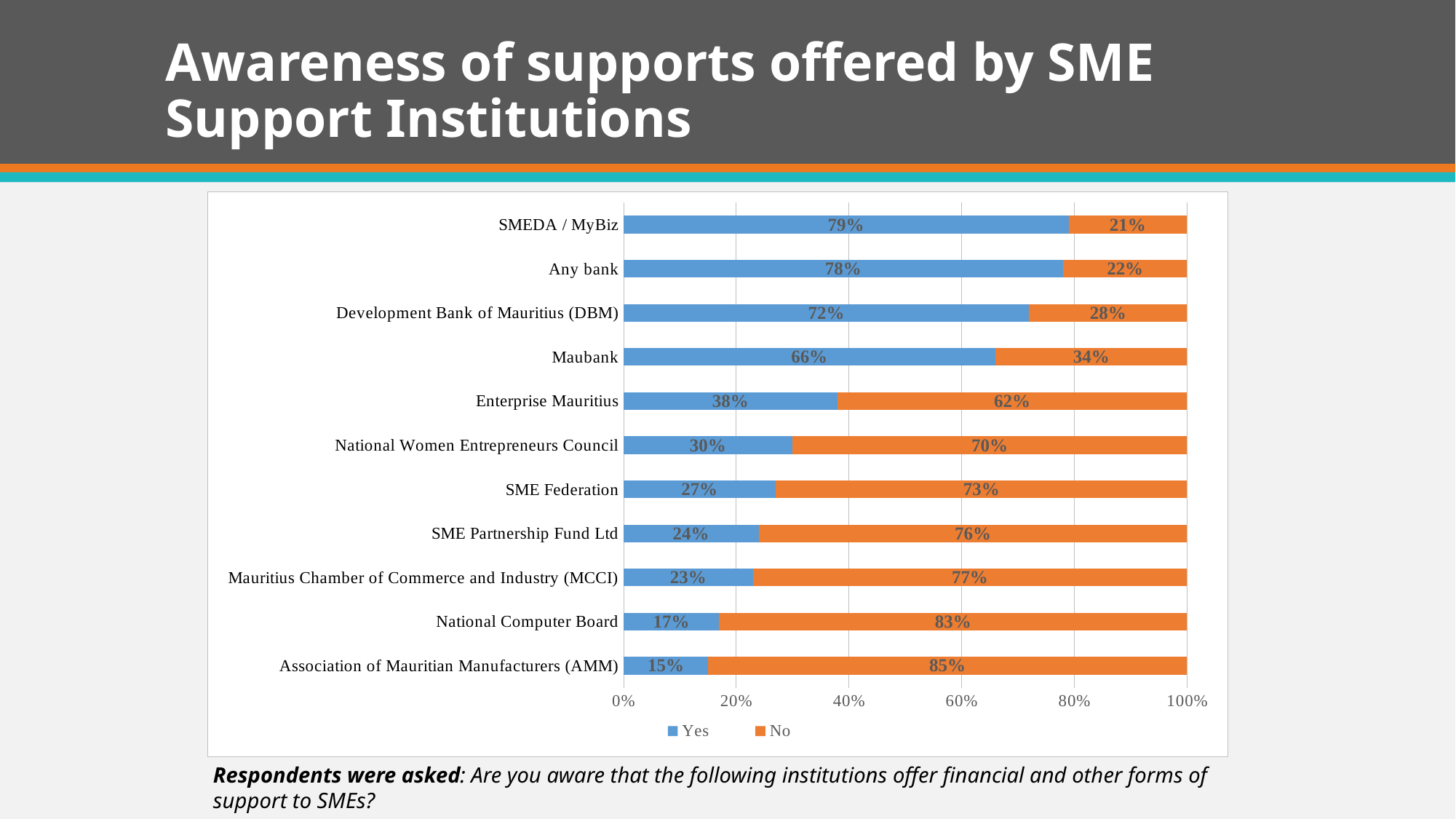
How many institutions are listed on the chart? 11 Which institution has the lowest Yes percentage? Association of Mauritian Manufacturers (AMM) What is the Yes value for the National Computer Board? 17% Which has a larger Yes percentage, Development Bank of Mauritius (DBM) or SME Federation? Development Bank of Mauritius (DBM) What is the difference between the Yes percentages for Maubank and Enterprise Mauritius? 28% What percentage of respondents answered No for Enterprise Mauritius? 62% What kind of chart is shown on the slide? Stacked bar chart What is the total of the Yes and No values for Any bank? 100% How many series does the legend list? 2 Which institution has the highest Yes percentage? SMEDA / MyBiz What percentage of respondents answered Yes for SMEDA / MyBiz? 79% Which colour represents the No responses in the chart? Orange